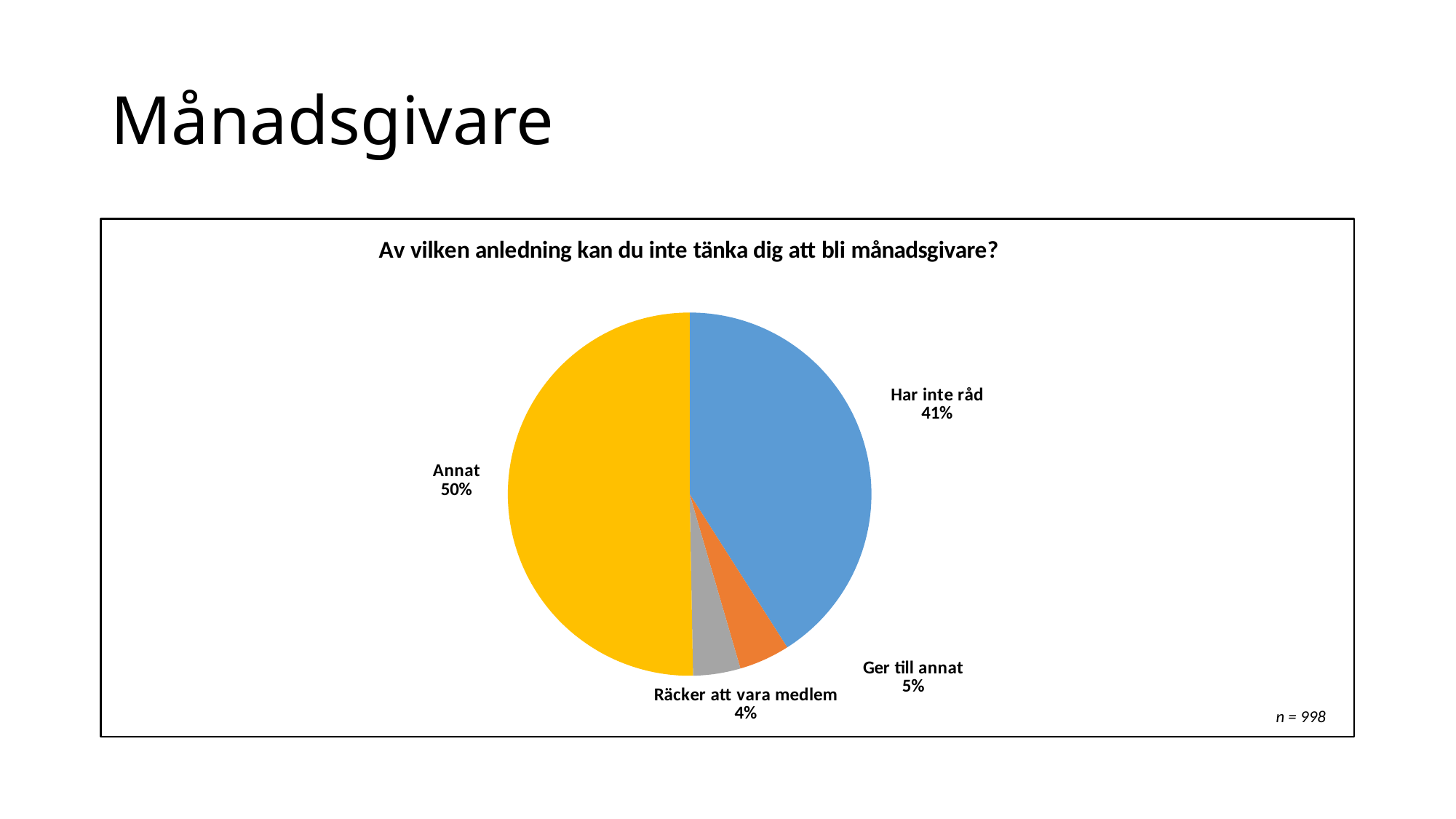
What kind of chart is shown on the slide? Pie chart What is the value shown for "Har inte råd"? 41% What is the value shown for "Ger till annat"? 5% Which category has the smallest slice of the pie? Räcker att vara medlem What share of the pie does "Annat" represent? 50% Which category has the largest slice of the pie? Annat What sample size (n) is noted on the chart? n = 998 How many categories are shown in the pie chart? 4 What is the value shown for "Räcker att vara medlem"? 4% What is the title of the chart? Av vilken anledning kan du inte tänka dig att bli månadsgivare? Which is larger, "Har inte råd" or "Ger till annat"? Har inte råd What is the difference in percentage points between "Annat" and "Har inte råd"? 9